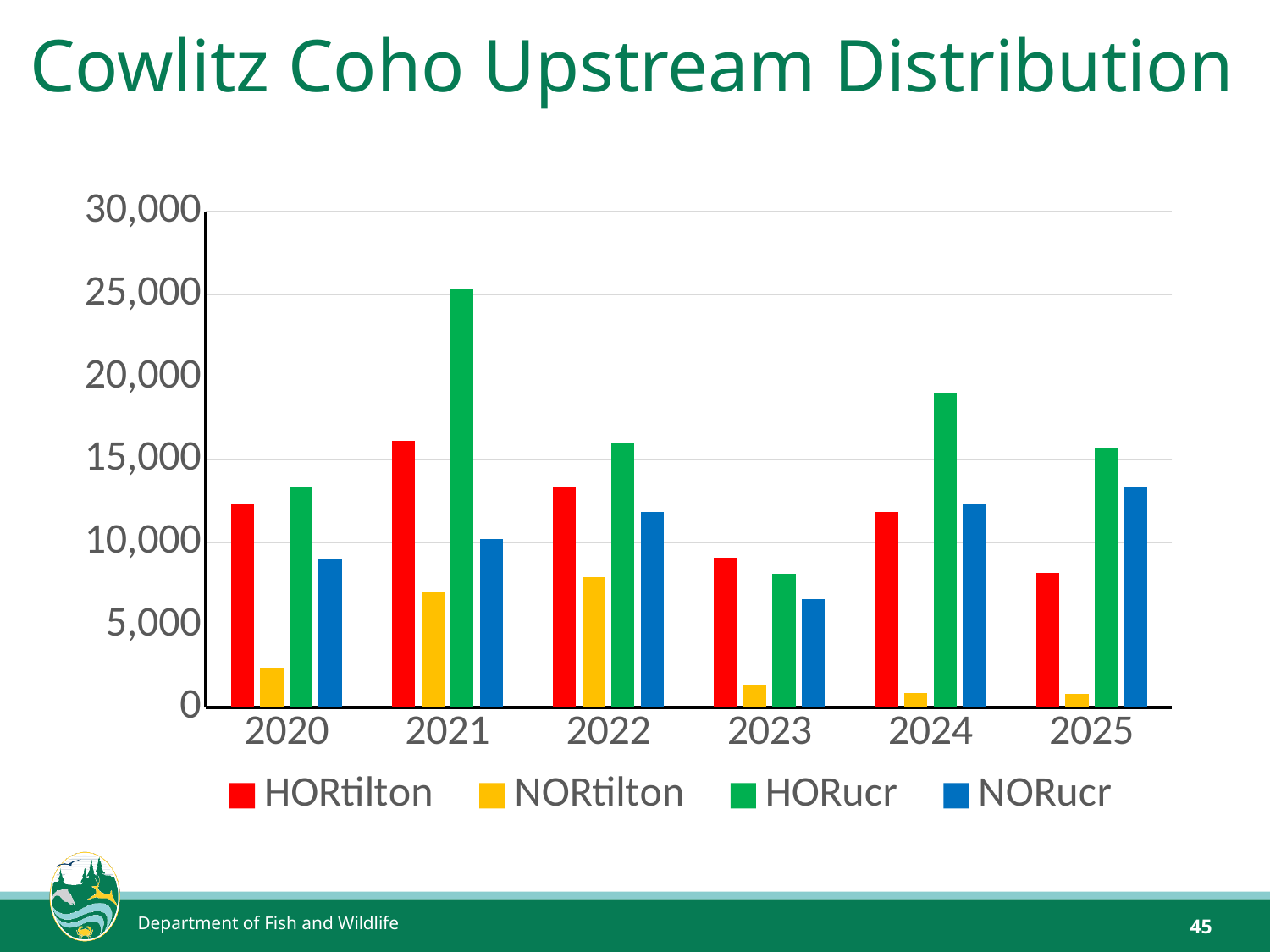
Is the value for HORucr in 2021 greater or less than 20,000? greater How many years are shown on the x axis? 6 In 2021, which is larger: HORtilton or HORucr? HORucr What kind of chart is shown on the slide? bar chart Is the value for HORtilton in 2021 greater or less than 15,000? greater In which year is the HORucr value highest? 2021 Does the NORtilton value rise or fall from 2022 to 2025? fall How many series does the legend list? 4 In 2025, which is larger: HORtilton or NORucr? NORucr What colour represents HORucr in the legend? green In which year is the NORucr value lowest? 2023 Is the value for NORtilton in 2020 greater or less than 5,000? less